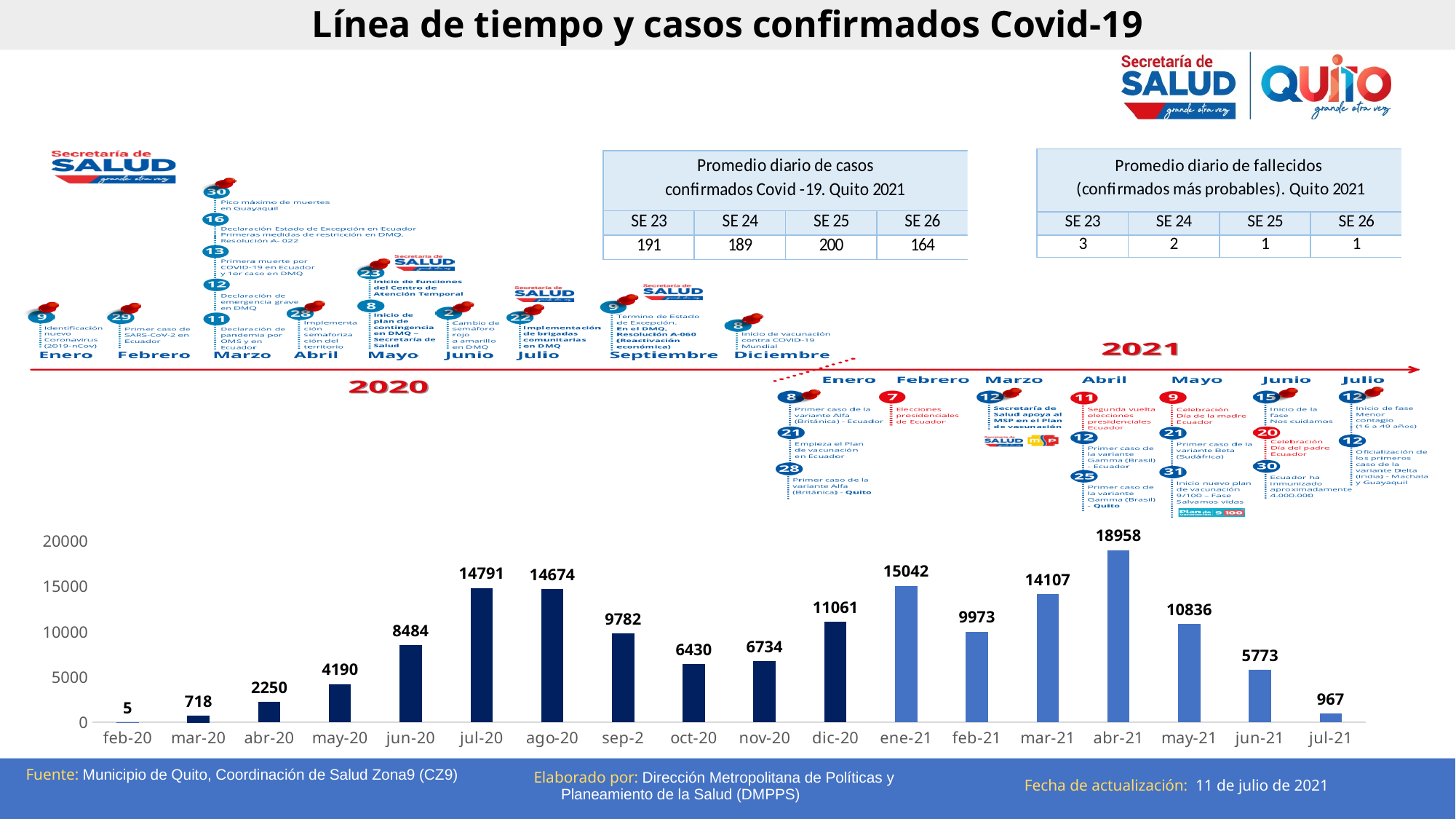
In the bar chart, which is larger, the value for ene-21 or the value for ago-20? ene-21 In the bar chart, what is the difference between the values for abr-21 and mar-21? 4851 Which month has the lowest value in the bar chart? feb-20 In the bar chart, do the values rise or fall from abr-21 to jul-21? fall Which month has the highest value in the bar chart? abr-21 In the bar chart, what is the value for feb-20? 5 In the bar chart, what is the difference between the values for jun-21 and jul-21? 4806 What type of chart is shown at the bottom of the slide? bar chart How many months (bars) are shown in the bar chart? 18 In the bar chart, what is the value for abr-21? 18958 In the bar chart, what is the value for dic-20? 11061 In the bar chart, what is the value for jul-20? 14791